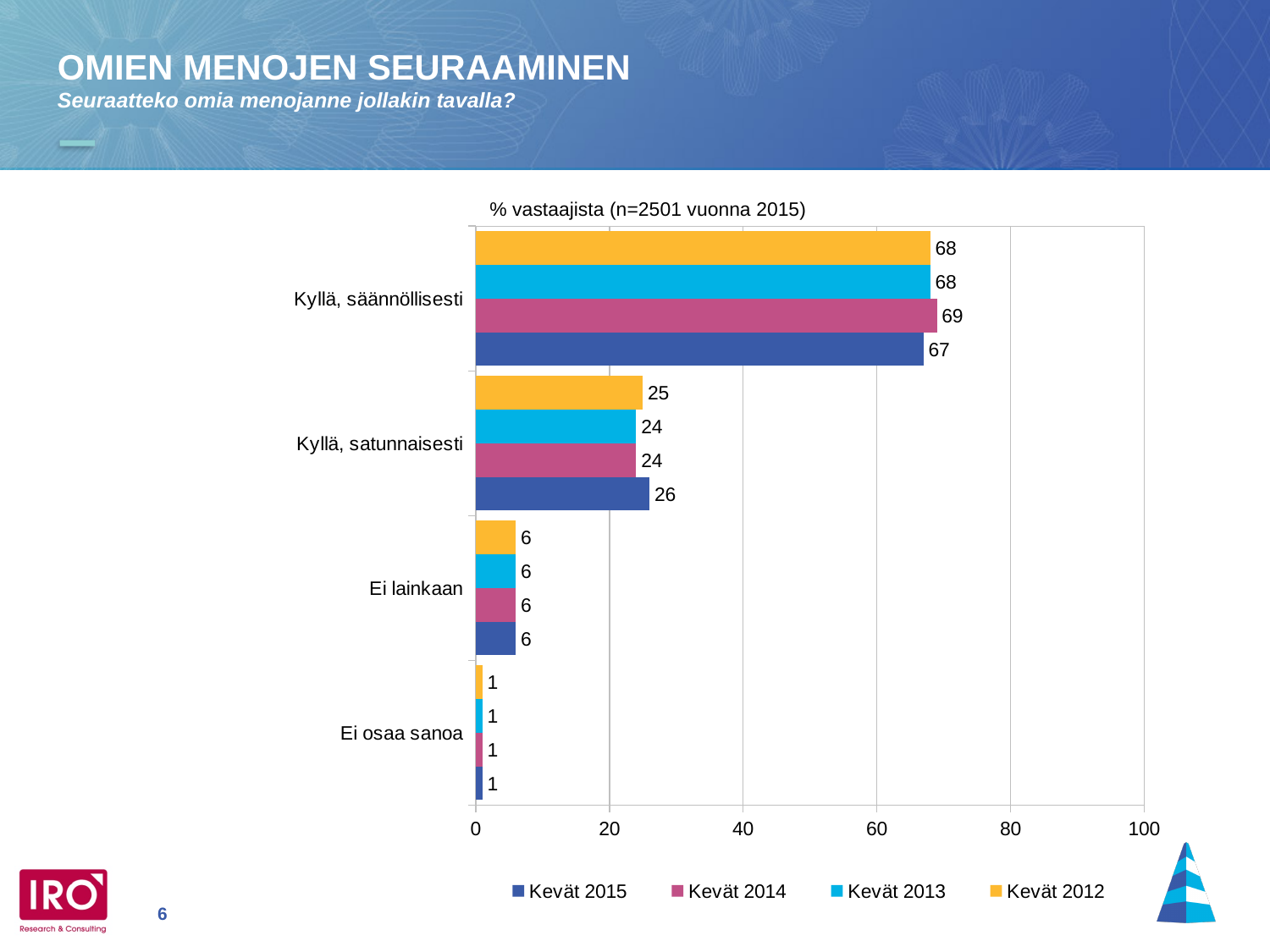
What is the value for "Kyllä, satunnaisesti" in the Kevät 2012 series? 25 What is the value for "Kyllä, säännöllisesti" in the Kevät 2015 series? 67 What kind of chart is shown on the slide? bar chart What is the value for "Kyllä, säännöllisesti" in the Kevät 2014 series? 69 Which category has the lowest value in the Kevät 2012 series? Ei osaa sanoa How many series does the legend list? 4 What is the value for "Ei lainkaan" in the Kevät 2013 series? 6 Is the Kevät 2013 value for "Kyllä, säännöllisesti" greater or less than 60? greater How many categories are shown on the chart? 4 Which is larger for "Kyllä, satunnaisesti": the Kevät 2015 value or the Kevät 2014 value? Kevät 2015 What is the difference between the Kevät 2015 values for "Kyllä, säännöllisesti" and "Kyllä, satunnaisesti"? 41 Which category has the highest value in the Kevät 2015 series? Kyllä, säännöllisesti